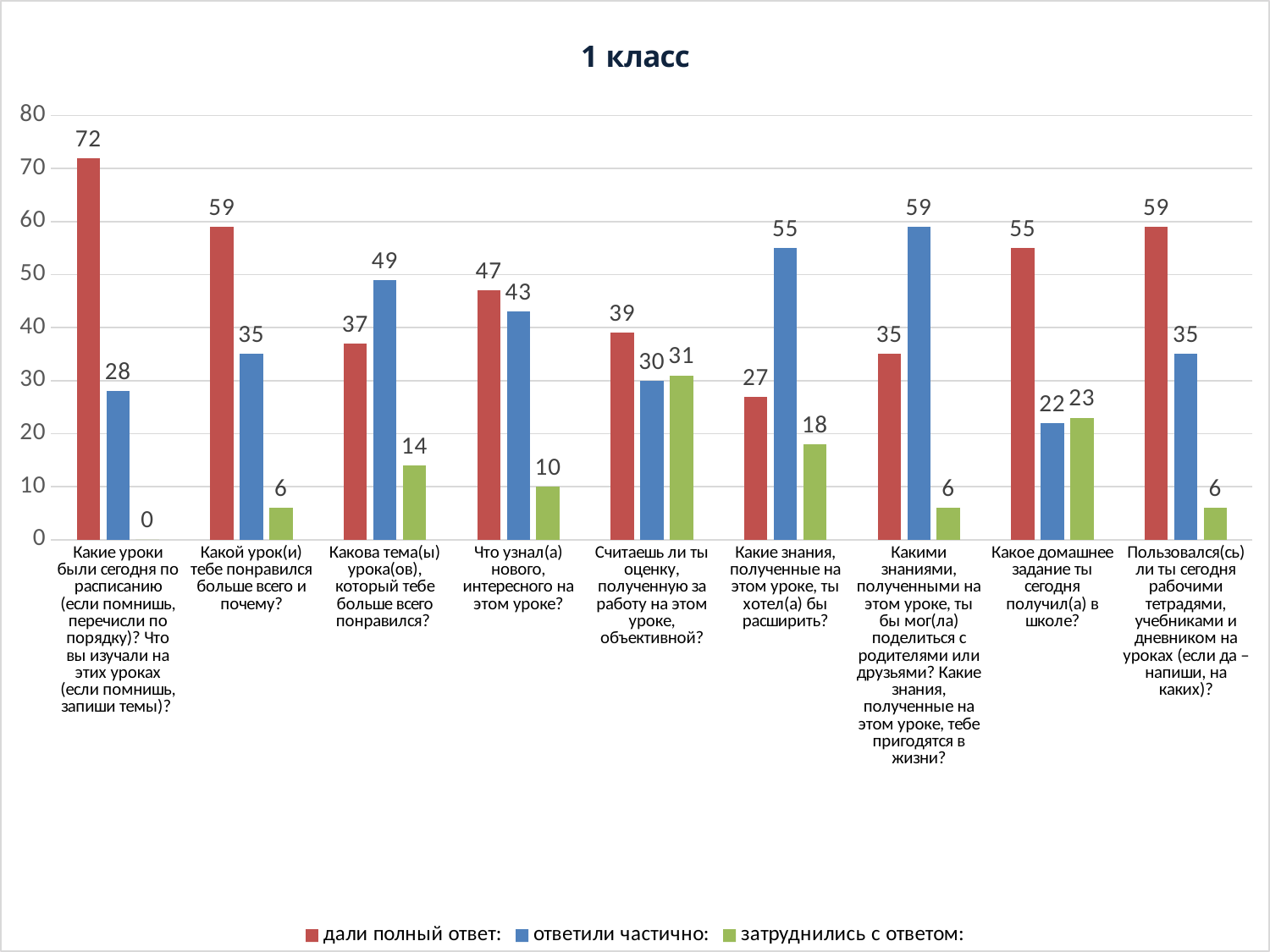
What is the difference between "дали полный ответ" and "ответили частично" for the question "Что узнал(а) нового, интересного на этом уроке?"? 4 For which question is the "дали полный ответ" value the highest? Какие уроки были сегодня по расписанию (если помнишь, перечисли по порядку)? Что вы изучали на этих уроках (если помнишь, запиши темы)? What is the title of the chart? 1 класс What is the value of "затруднились с ответом" for the question "Какое домашнее задание ты сегодня получил(а) в школе?"? 23 What is the value of "ответили частично" for the question "Какие знания, полученные на этом уроке, ты хотел(а) бы расширить?"? 55 How many series does the legend list? 3 How many question categories are shown on the x axis? 9 For which question is the "затруднились с ответом" value the lowest? Какие уроки были сегодня по расписанию (если помнишь, перечисли по порядку)? Что вы изучали на этих уроках (если помнишь, запиши темы)? What is the value of "затруднились с ответом" for the question "Какова тема(ы) урока(ов), который тебе больше всего понравился?"? 14 What is the value of "дали полный ответ" for the question "Какие уроки были сегодня по расписанию..."? 72 For the question "Какими знаниями, полученными на этом уроке, ты бы мог(ла) поделиться с родителями или друзьями?...", which is larger: "дали полный ответ" or "ответили частично"? ответили частично What type of chart is shown on the slide? bar chart